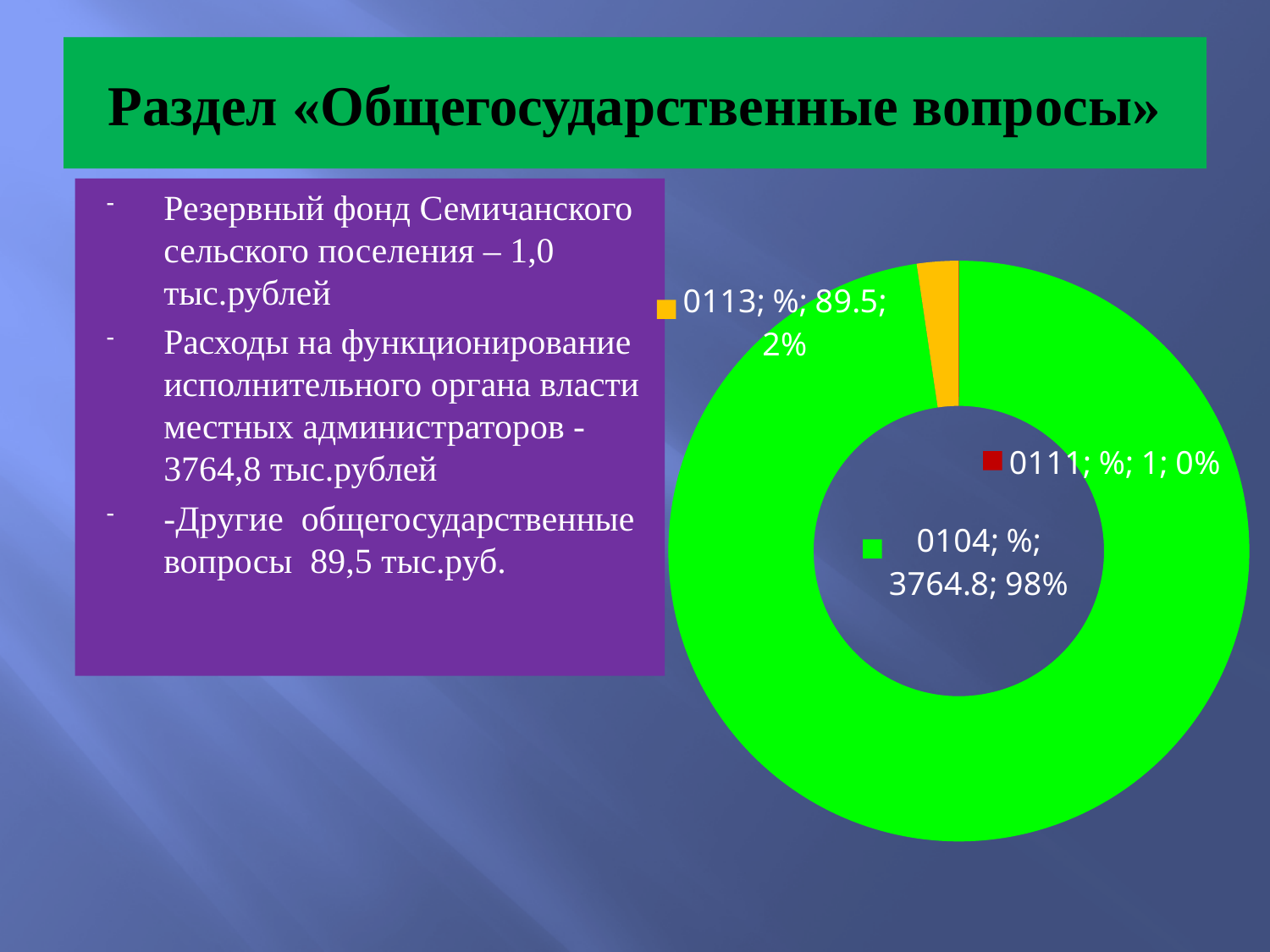
What is the value shown for category 0111? 1 What is the value shown for category 0113? 89.5 Which category has the largest slice of the doughnut chart? 0104 Which category has the smallest slice of the doughnut chart? 0111 What is the value shown for category 0104? 3764.8 What colour is the slice for category 0104? green How many categories does the doughnut chart show? 3 What share of the doughnut chart does category 0104 represent? 98% What is the difference between the values for 0104 and 0113? 3675.3 Which is larger, the value for 0113 or the value for 0111? 0113 What kind of chart is shown on the slide? doughnut chart What share of the doughnut chart does category 0113 represent? 2%